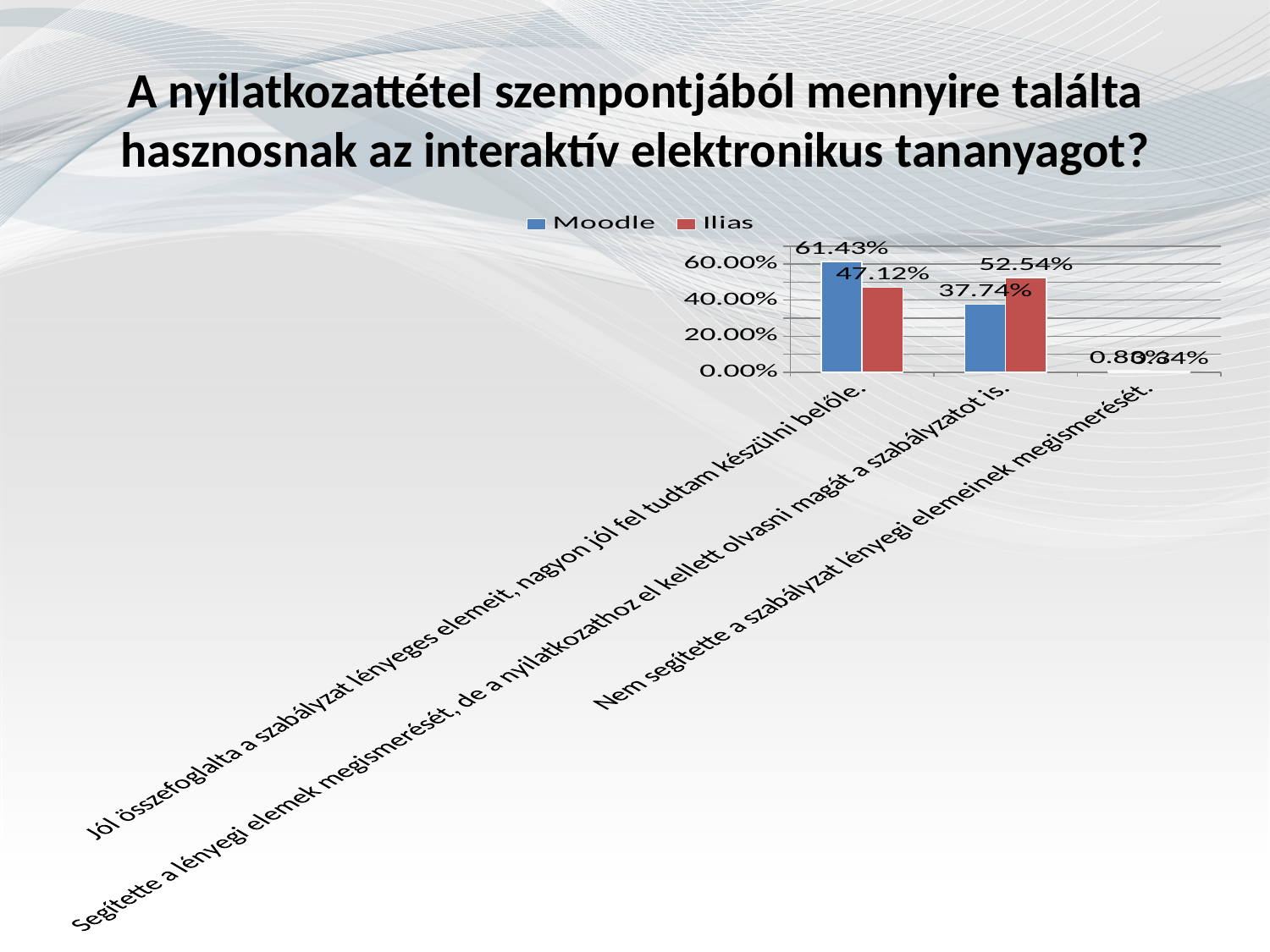
What is the Ilias value for the category 'Segítette a lényegi elemek megismerését, de a nyilatkozathoz el kellett olvasni magát a szabályzatot is.'? 52.54% How many series does the legend list? 2 For the category 'Segítette a lényegi elemek megismerését, de a nyilatkozathoz el kellett olvasni magát a szabályzatot is.', which series has the larger value, Moodle or Ilias? Ilias Which category has the highest Ilias value? Segítette a lényegi elemek megismerését, de a nyilatkozathoz el kellett olvasni magát a szabályzatot is. Which category has the highest Moodle value? Jól összefoglalta a szabályzat lényeges elemeit, nagyon jól fel tudtam készülni belőle. What is the Moodle value for the category 'Segítette a lényegi elemek megismerését, de a nyilatkozathoz el kellett olvasni magát a szabályzatot is.'? 37.74% What is the difference between the Moodle and Ilias values for the category 'Jól összefoglalta a szabályzat lényeges elemeit, nagyon jól fel tudtam készülni belőle.'? 14.31% How many categories are shown on the x axis? 3 Which series are listed in the legend? Moodle and Ilias What kind of chart is shown on the slide? bar chart What is the Moodle value for the category 'Jól összefoglalta a szabályzat lényeges elemeit, nagyon jól fel tudtam készülni belőle.'? 61.43% What is the Ilias value for the category 'Jól összefoglalta a szabályzat lényeges elemeit, nagyon jól fel tudtam készülni belőle.'? 47.12%